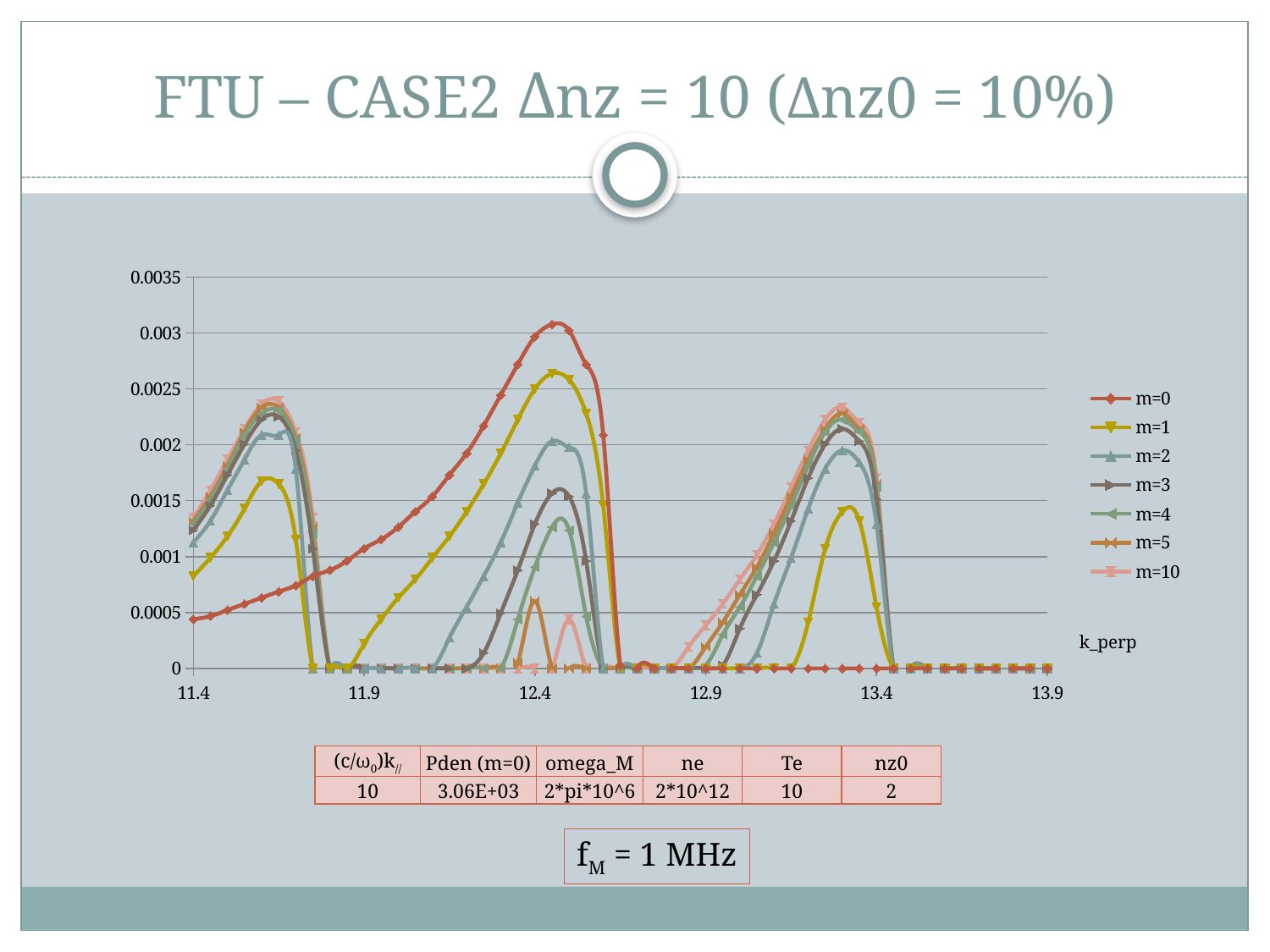
Is the peak value of the m=1 series greater or less than 0.003? less Does the m=0 series rise or fall as k_perp increases from 11.4 to 12.4? rise What are the series names listed in the chart legend? m=0, m=1, m=2, m=3, m=4, m=5, m=10 Which series reaches the highest peak value on the chart? m=0 Is the peak value of the m=5 series greater or less than 0.001? greater In the middle peak around k_perp = 12.4, which series reaches a higher value, m=2 or m=3? m=2 What kind of chart is shown on the slide? line chart What is the highest value shown on the y axis of the chart? 0.0035 Is the peak value of the m=0 series greater or less than 0.0025? greater What is the label of the x axis of the chart? k_perp How many series does the chart legend list? 7